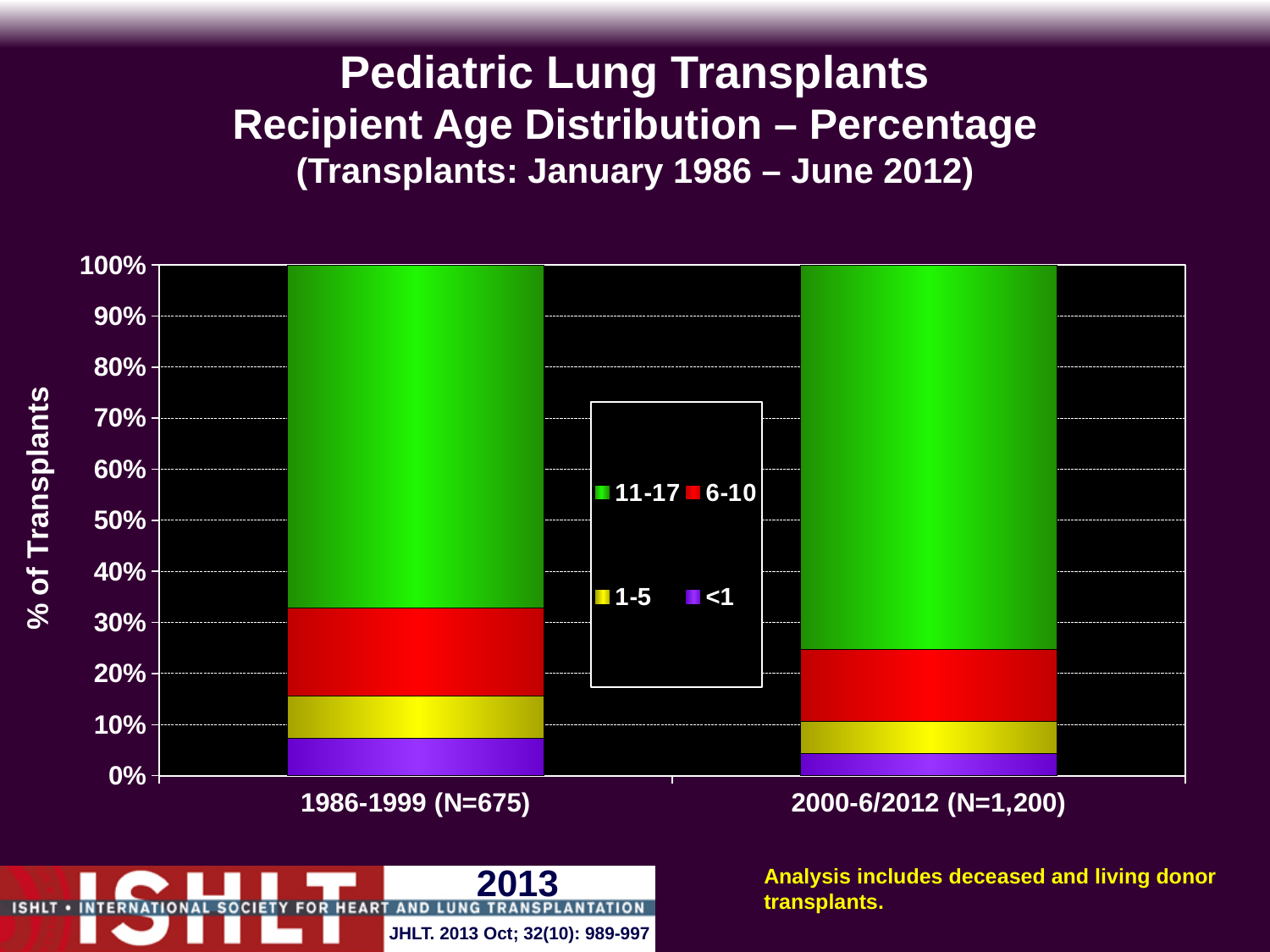
What is the label of the y axis? % of Transplants Which age group is represented by the green segments? 11-17 Is the share of the <1 age group in 2000-6/2012 (N=1,200) greater or less than 10%? less How many age groups does the legend list? 4 Is the share of the 11-17 age group larger in 1986-1999 (N=675) or in 2000-6/2012 (N=1,200)? 2000-6/2012 (N=1,200) How many time-period categories are shown on the x axis? 2 Which age group makes up the largest share of transplants in 1986-1999 (N=675)? 11-17 Is the share of the 11-17 age group in 2000-6/2012 (N=1,200) greater or less than 70%? greater What is the total height of the stacked bar for 2000-6/2012 (N=1,200)? 100% What kind of chart is shown on the slide? Stacked bar chart Which age group makes up the smallest share of transplants in 2000-6/2012 (N=1,200)? <1 Does the share of the <1 age group rise or fall from 1986-1999 to 2000-6/2012? fall